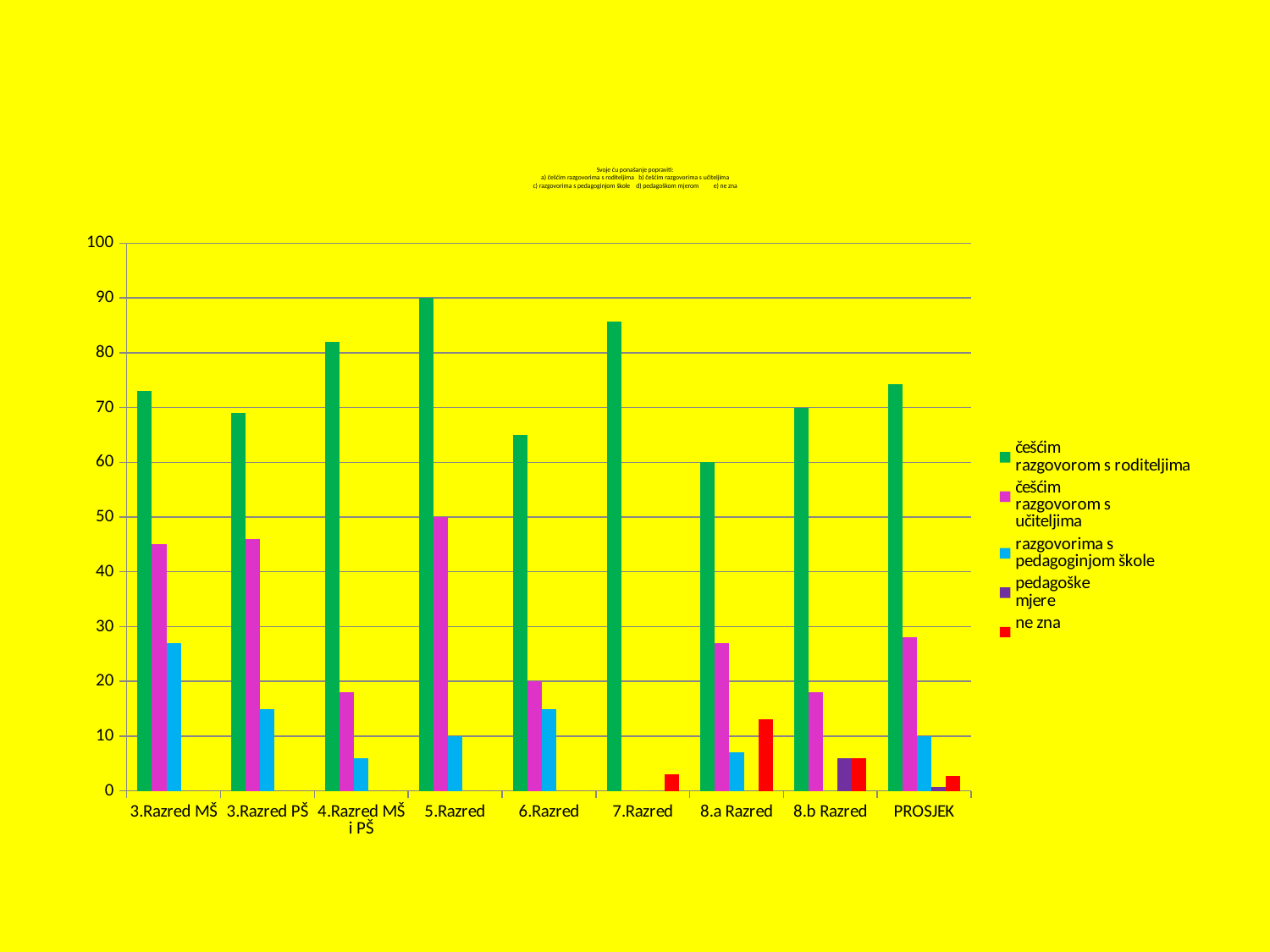
Is the value for 'češćim razgovorom s učiteljima' in PROSJEK greater or less than 30? less Which series is shown in green in the legend? češćim razgovorom s roditeljima Which is larger for 'češćim razgovorom s roditeljima': 4.Razred MŠ i PŠ or 3.Razred PŠ? 4.Razred MŠ i PŠ How many series does the legend list? 5 What is the value for 'češćim razgovorom s roditeljima' in 5.Razred? 90 How many categories are shown along the x axis? 9 Is the value for 'ne zna' in 8.a Razred greater or less than 10? greater Which category has the lowest value for the 'češćim razgovorom s roditeljima' series? 8.a Razred Which category has the highest value for the 'češćim razgovorom s roditeljima' series? 5.Razred What kind of chart is shown on the slide? bar chart Is the value for 'češćim razgovorom s roditeljima' in 7.Razred greater or less than 80? greater What is the value for 'češćim razgovorom s učiteljima' in 5.Razred? 50